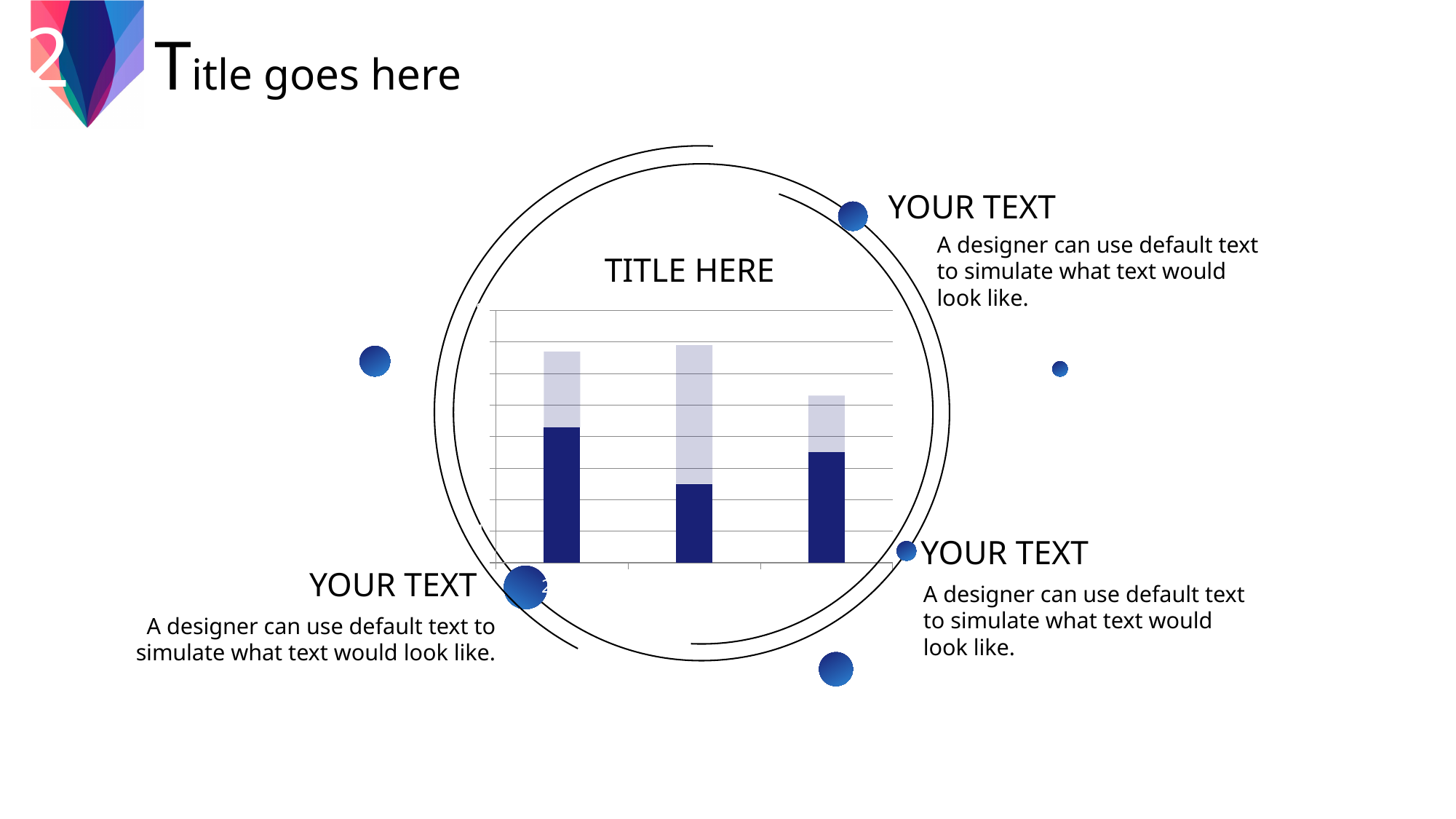
What kind of chart is shown on the slide? stacked bar chart What is the title of the chart? TITLE HERE Which bar (left, middle or right) has the shortest dark blue segment? middle How many bars does the chart contain? 3 Which bar (left, middle or right) has the smallest total height? right Is the dark blue segment of the left bar taller or shorter than the dark blue segment of the middle bar? taller How many segments (series) does each bar in the chart have? 2 Which bar (left, middle or right) has the tallest dark blue segment? left Which bar (left, middle or right) has the tallest light-coloured segment? middle Which bar (left, middle or right) reaches the greatest total height? middle What two colours are used for the segments of the bars? dark blue and light lavender